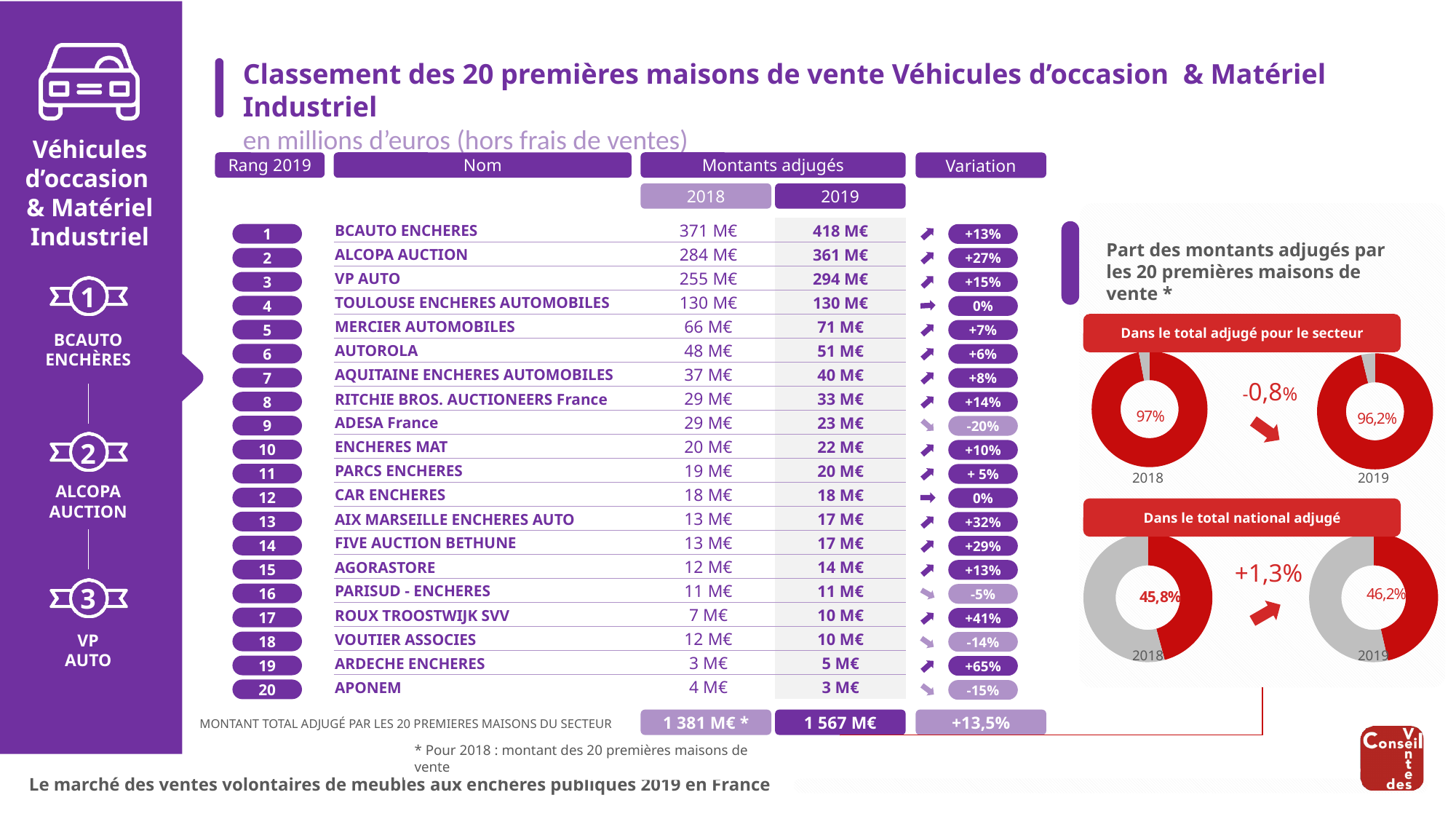
In the 'Dans le total national adjugé' charts, does the share rise or fall from 2018 to 2019? Rise In the 'Dans le total national adjugé' charts, what change between 2018 and 2019 is printed between the two donuts? +1,3% In the 'Dans le total national adjugé' charts, which year has the larger share, 2018 or 2019? 2019 In the 'Dans le total adjugé pour le secteur' charts, does the share rise or fall from 2018 to 2019? Fall In the 'Dans le total adjugé pour le secteur' charts, what share is shown for 2019? 96,2% What kind of chart is used to show the shares under 'Dans le total adjugé pour le secteur'? Donut (pie) chart In the 'Dans le total adjugé pour le secteur' charts, what share is shown for 2018? 97% In the 'Dans le total national adjugé' charts, what share is shown for 2018? 45,8% In the 'Dans le total adjugé pour le secteur' charts, what change between 2018 and 2019 is printed between the two donuts? -0,8% How many donut charts are shown on the right side of the slide? 4 In the 'Dans le total national adjugé' charts, what share is shown for 2019? 46,2% What colour is used for the highlighted share in the donut charts? Red